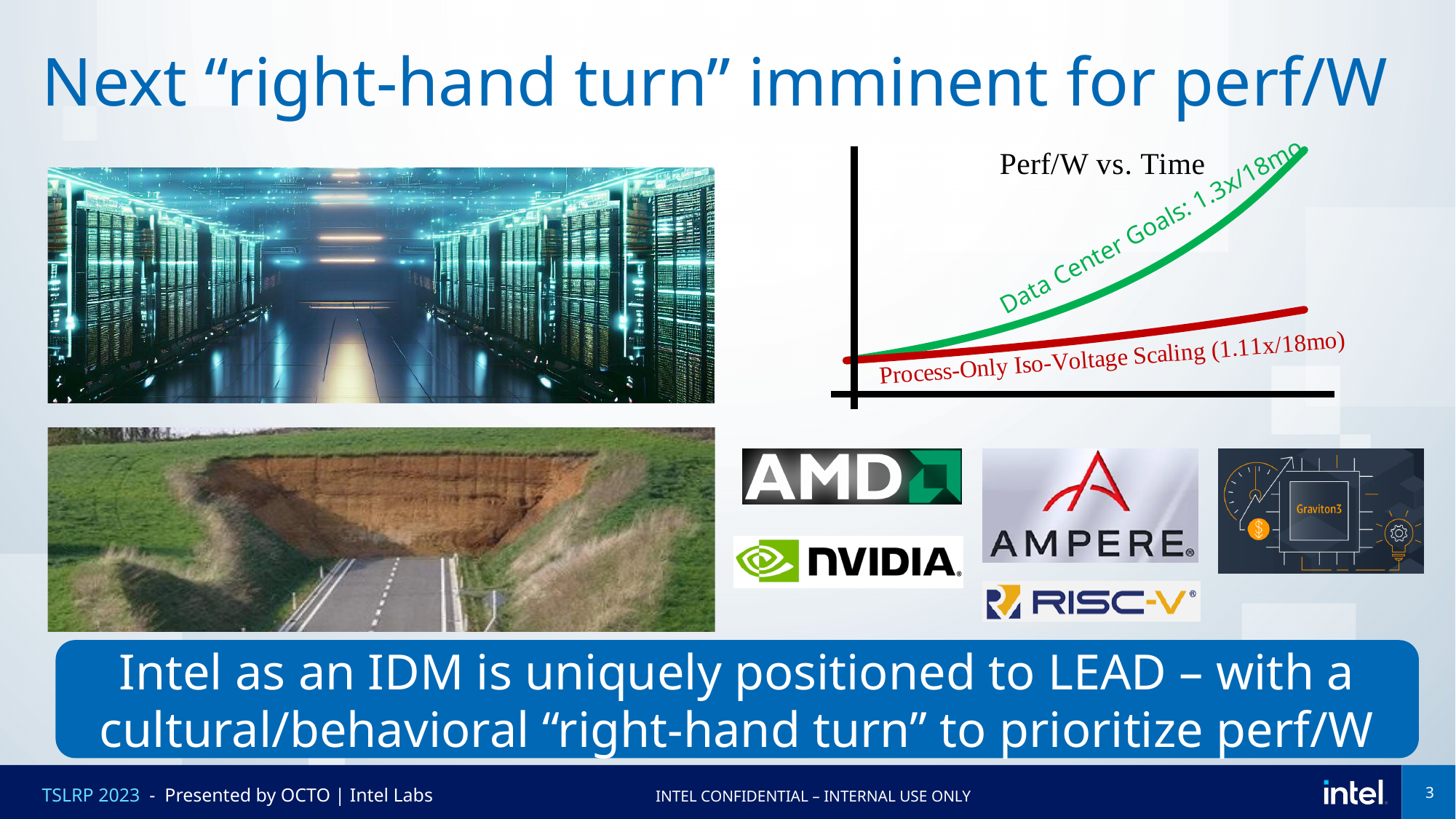
What kind of chart is the "Perf/W vs. Time" chart? line chart On the "Perf/W vs. Time" chart, what scaling rate per 18 months is given for Process-Only Iso-Voltage Scaling? 1.11x/18mo On the "Perf/W vs. Time" chart, what scaling rate per 18 months is given for Data Center Goals? 1.3x/18mo On the "Perf/W vs. Time" chart, does the Process-Only Iso-Voltage Scaling line rise or fall over time? rise On the "Perf/W vs. Time" chart, which line has the steeper growth: Data Center Goals or Process-Only Iso-Voltage Scaling? Data Center Goals On the "Perf/W vs. Time" chart, what is the label of the green line? Data Center Goals: 1.3x/18mo On the "Perf/W vs. Time" chart, which line is higher at the right end of the time axis: Data Center Goals or Process-Only Iso-Voltage Scaling? Data Center Goals On the "Perf/W vs. Time" chart, does the Data Center Goals line rise or fall over time? rise How many lines are plotted on the "Perf/W vs. Time" chart? 2 On the "Perf/W vs. Time" chart, what is the label of the red line? Process-Only Iso-Voltage Scaling (1.11x/18mo) What is the title of the chart on the slide? Perf/W vs. Time On the "Perf/W vs. Time" chart, which line has the lower scaling rate per 18 months? Process-Only Iso-Voltage Scaling